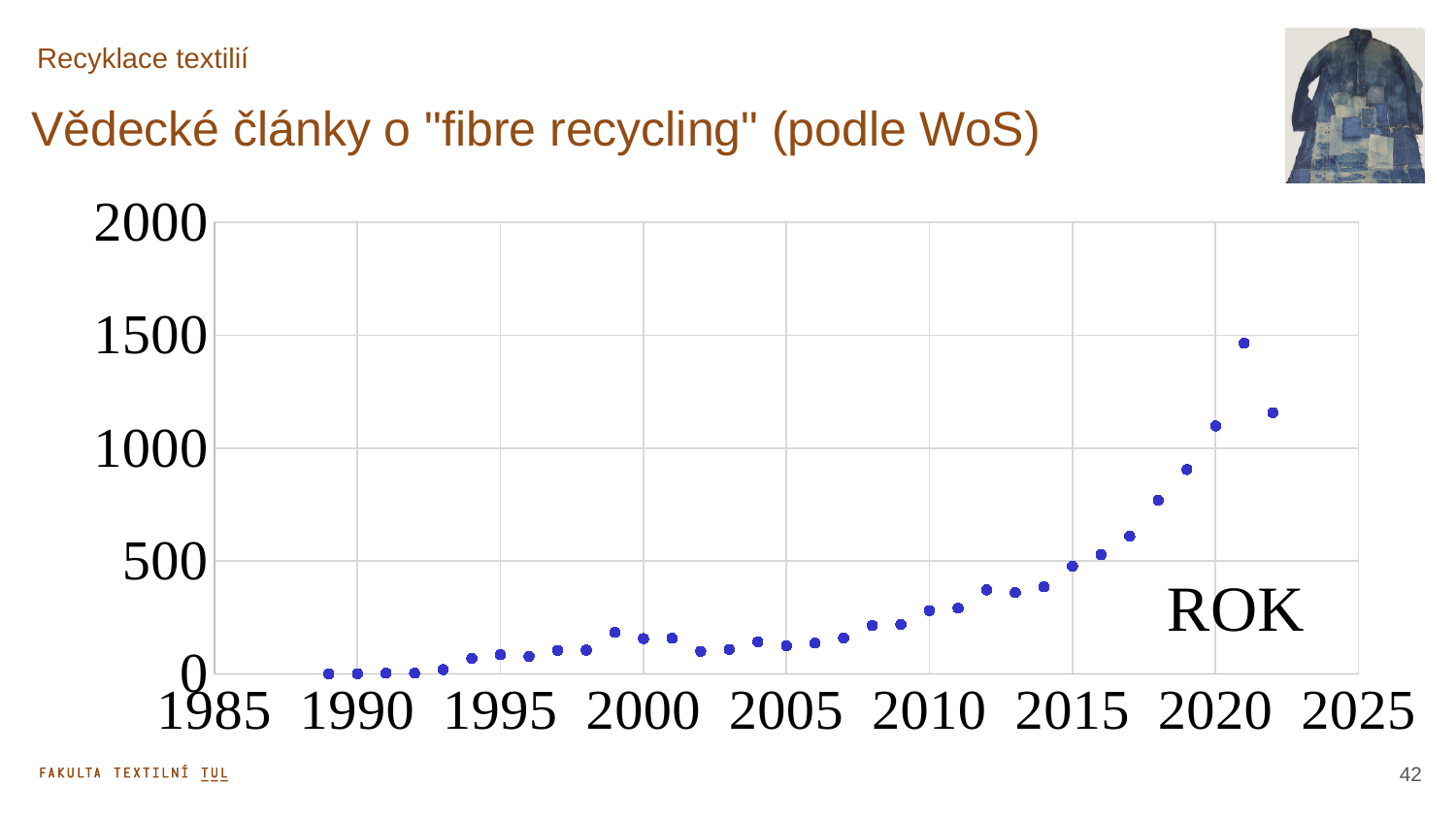
Which year has the larger value, 2005 or 2015? 2015 Is the value for 2010 greater or less than 500? less Is the value for 2021 greater or less than 1000? greater Is the value for 2020 greater or less than 1000? greater What is the title of the chart? Vědecké články o "fibre recycling" (podle WoS) Which year has the larger value, 2021 or 2022? 2021 Do the values generally rise or fall as the year increases along the x axis? rise Which year has the highest number of articles? 2021 What label is shown for the x axis of the chart? ROK What kind of chart is shown on the slide? scatter chart Which year has the larger value, 2019 or 2020? 2020